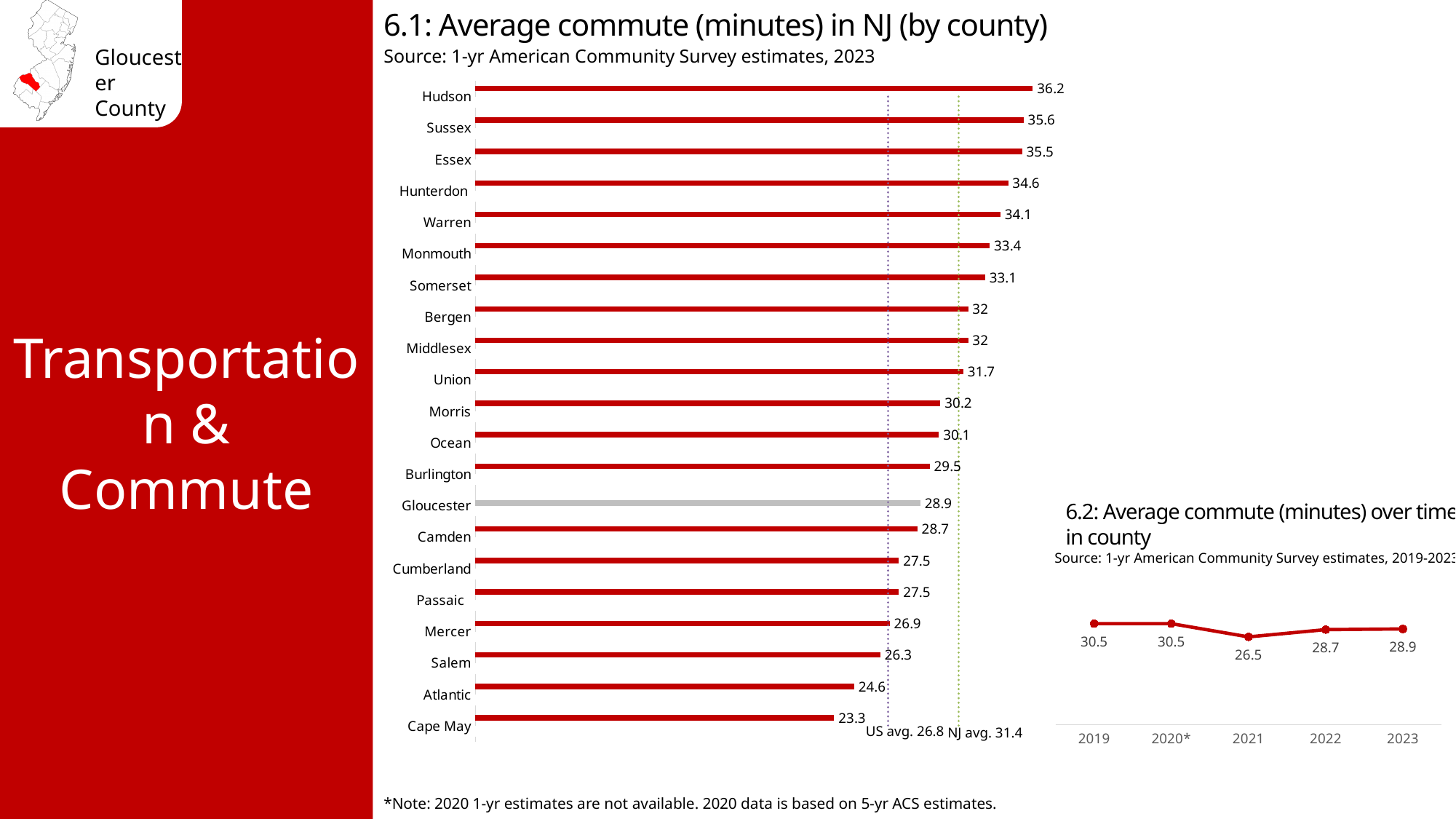
In chart 6.1 (Average commute in NJ by county), which county has the highest average commute? Hudson What kind of chart is chart 6.1 (Average commute in NJ by county)? Bar chart What kind of chart is chart 6.2 (Average commute over time in county)? Line chart In chart 6.1 (Average commute in NJ by county), what is the US average commute shown by the reference line? 26.8 In chart 6.1 (Average commute in NJ by county), which county has the lowest average commute? Cape May In chart 6.2 (Average commute over time in county), what was the average commute in 2021? 26.5 In chart 6.1 (Average commute in NJ by county), how many counties are shown? 21 In chart 6.2 (Average commute over time in county), which year has the lowest average commute? 2021 In chart 6.1 (Average commute in NJ by county), what is the average commute for Gloucester? 28.9 In chart 6.1 (Average commute in NJ by county), what is the NJ average commute shown by the reference line? 31.4 In chart 6.1 (Average commute in NJ by county), what is the difference between Hudson's and Cape May's average commute? 12.9 In chart 6.1 (Average commute in NJ by county), which has a longer average commute, Camden or Burlington? Burlington